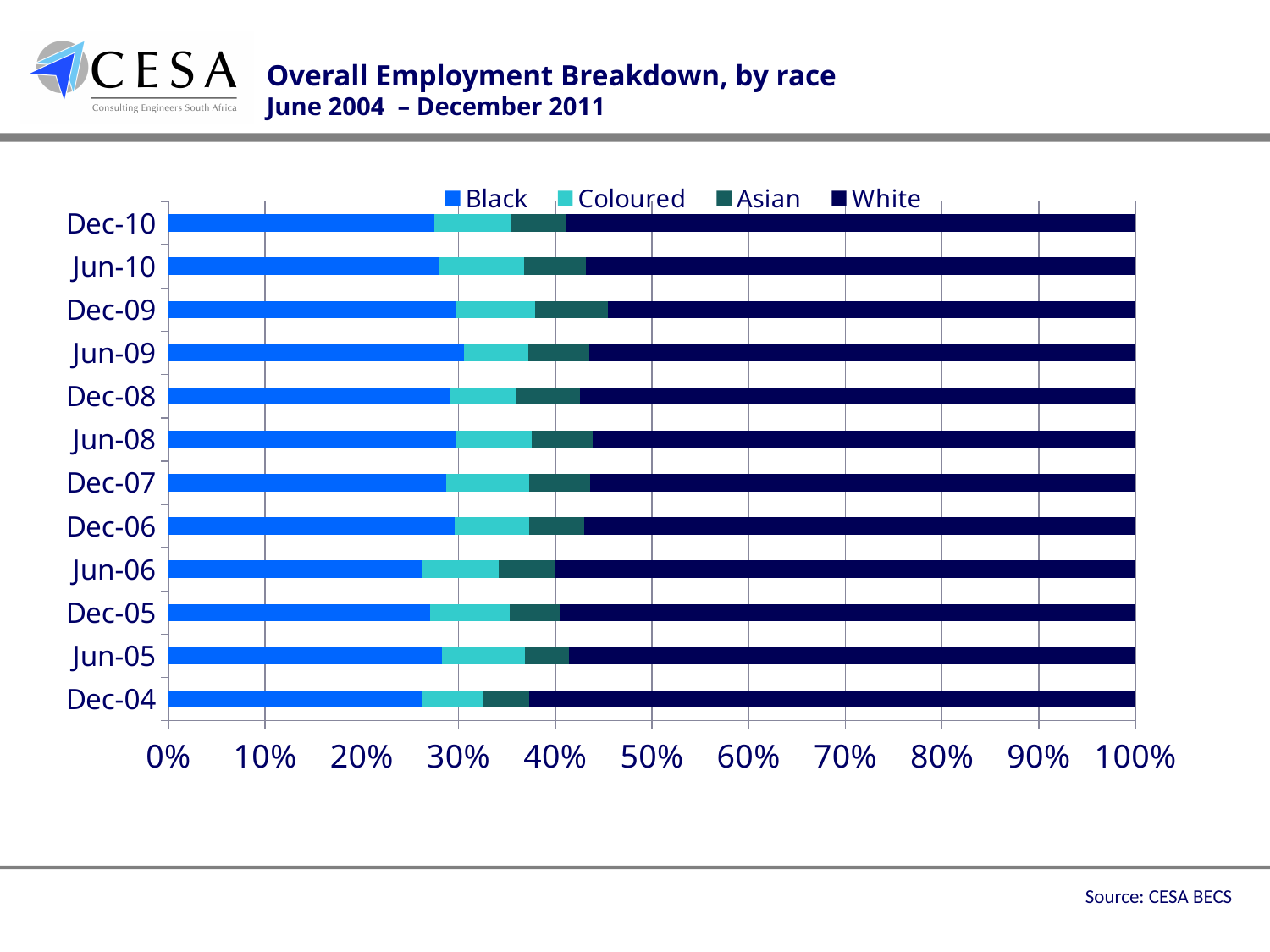
Is the White share for Dec-04 greater or less than 60%? greater Which is larger, the White share for Dec-04 or for Dec-09? Dec-04 Is the Black share for Dec-04 greater or less than 30%? less Which series is listed first in the legend? Black What kind of chart is shown on the slide? Stacked bar chart Is the Black share for Jun-06 greater or less than 30%? less Which period has the largest White share? Dec-04 What is the title of the chart? Overall Employment Breakdown, by race June 2004 – December 2011 How many series does the legend list? 4 Which is larger, the Black share for Dec-09 or for Dec-04? Dec-09 How many time periods are shown on the vertical axis? 12